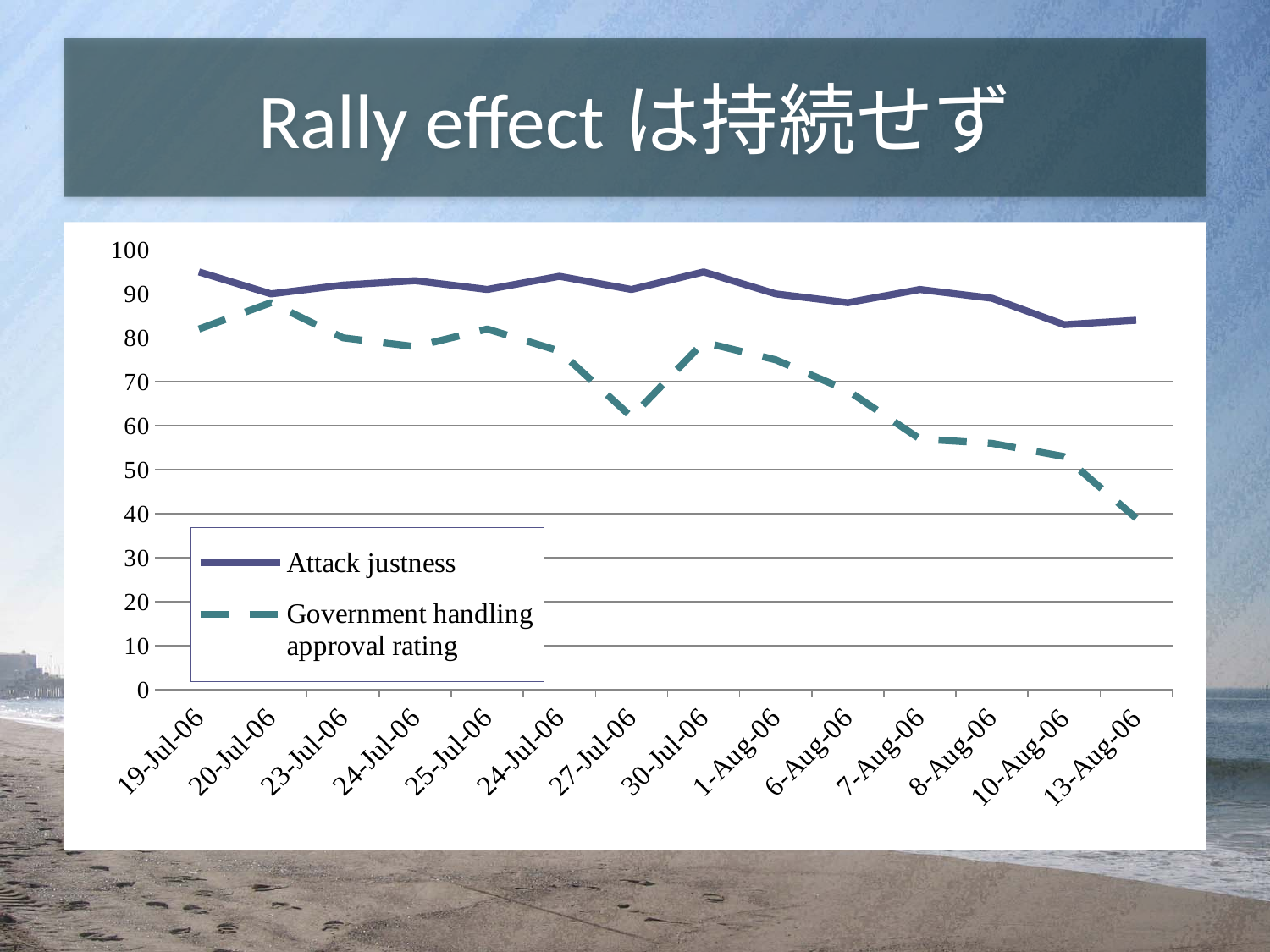
Is the Attack justness value on 30-Jul-06 greater or less than 90? greater Is the Attack justness value on 13-Aug-06 greater or less than 80? greater On which date is the Government handling approval rating highest? 20-Jul-06 On which date is the Government handling approval rating lowest? 13-Aug-06 Which series is drawn with a dashed line? Government handling approval rating What kind of chart is shown on the slide? line chart Is the Government handling approval rating on 10-Aug-06 greater or less than 50? greater How many series does the legend list? 2 Does the Government handling approval rating rise or fall overall from 19-Jul-06 to 13-Aug-06? fall On 13-Aug-06, which series has the larger value, Attack justness or Government handling approval rating? Attack justness How many dates are shown along the x axis? 14